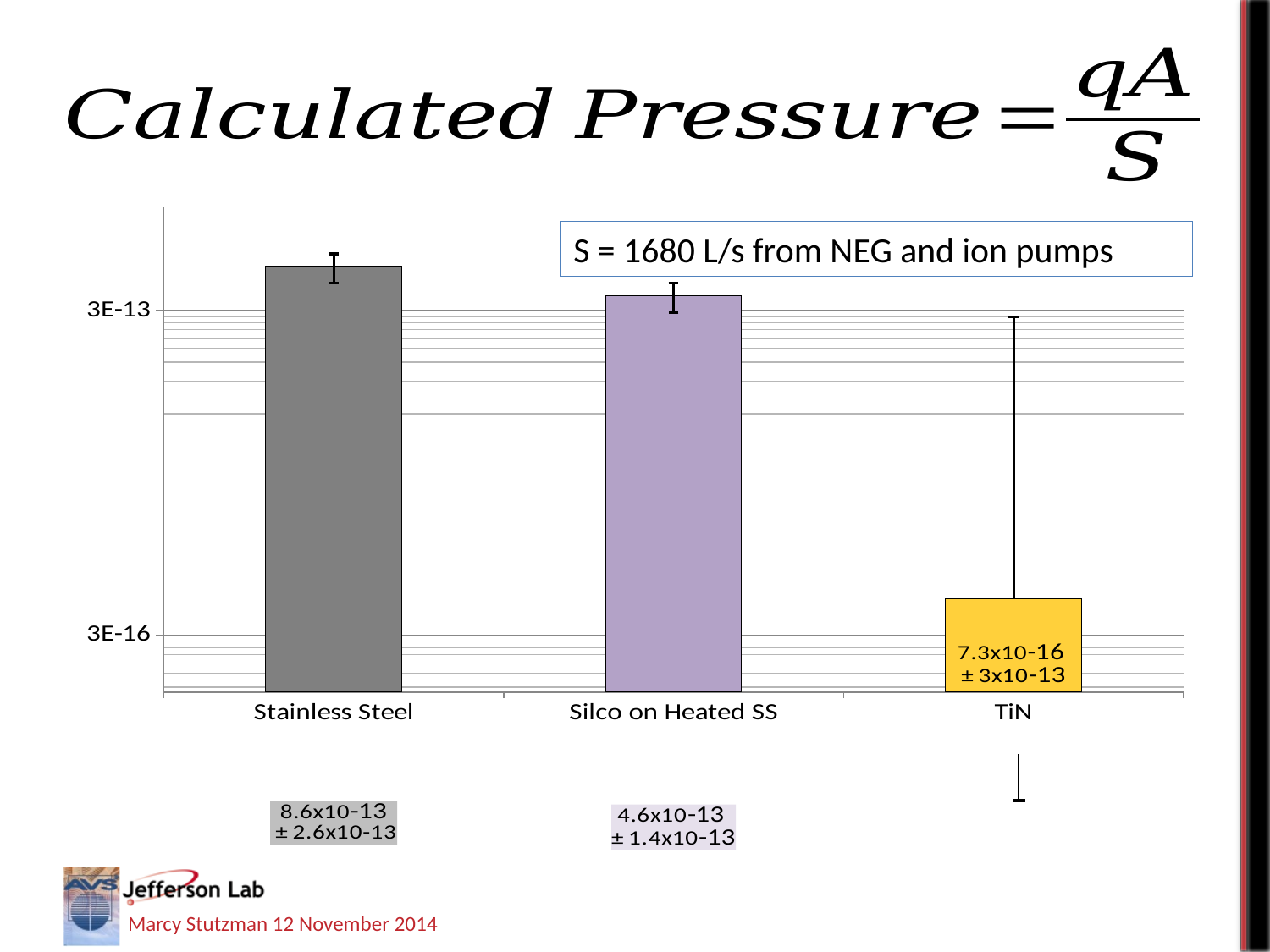
What is the calculated pressure value labelled for TiN? 7.3x10-16 How many materials are plotted in the chart? 3 Which material has the lowest calculated pressure? TiN What is the calculated pressure value labelled for Silco on Heated SS? 4.6x10-13 Which material has the highest calculated pressure? Stainless Steel What kind of chart is shown on the slide? bar chart Which has the larger calculated pressure, Silco on Heated SS or TiN? Silco on Heated SS What is the calculated pressure value labelled for Stainless Steel? 8.6x10-13 What uncertainty is given for the Stainless Steel value? ± 2.6x10-13 Is the value for Stainless Steel greater or less than 3E-13? greater What uncertainty is given for the TiN value? ± 3x10-13 What pumping speed S is stated in the text box on the chart? 1680 L/s